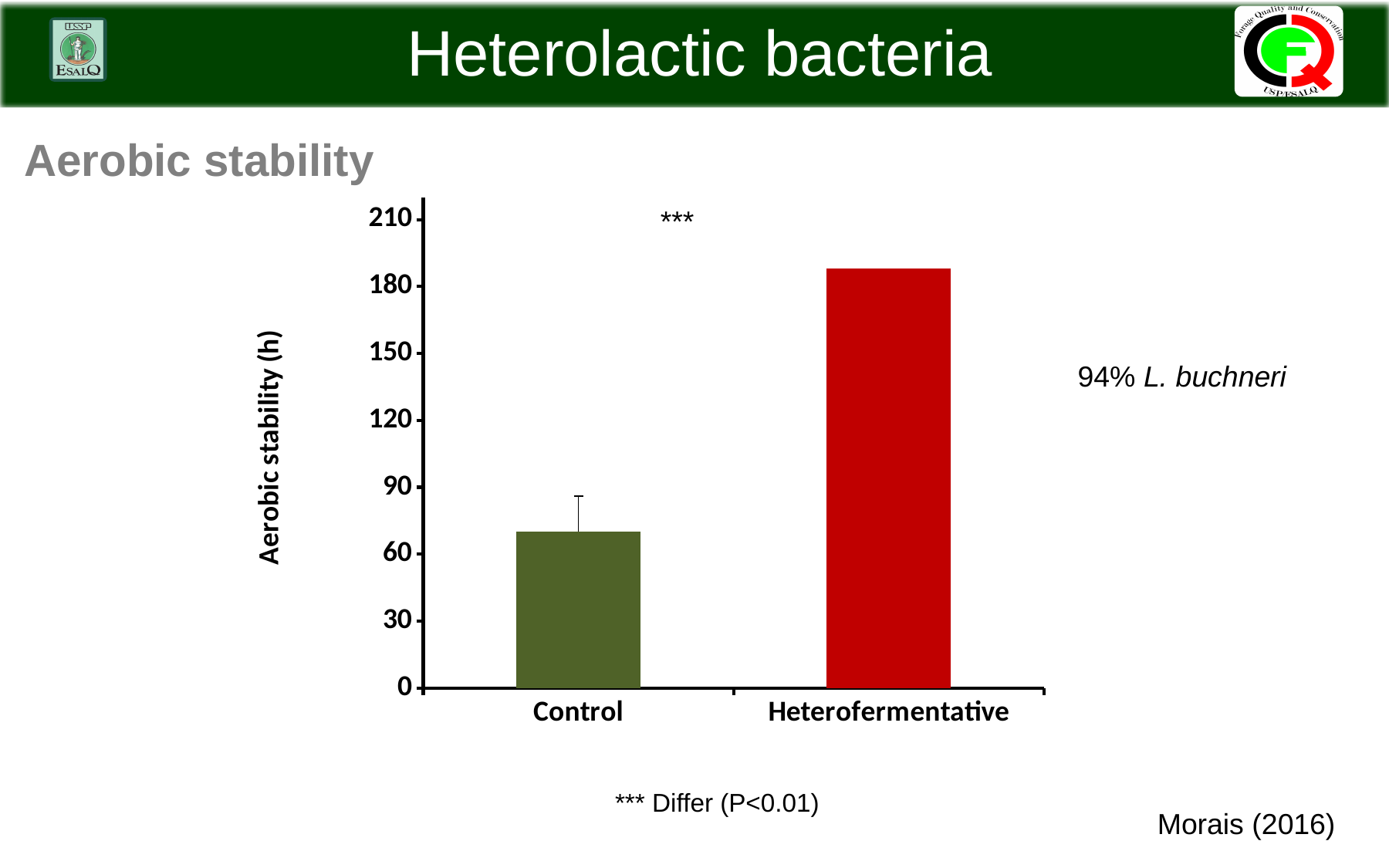
What is the label of the y axis? Aerobic stability (h) Is the value for Heterofermentative greater or less than 180? greater Which category has the highest aerobic stability? Heterofermentative Is the value for Heterofermentative greater or less than 210? less Which category has the lowest aerobic stability? Control Is the value for Control greater or less than 90? less What colour is the bar for Heterofermentative? red What kind of chart is shown on the slide? bar chart How many categories are plotted on the x axis? 2 Which is larger, the aerobic stability for Control or for Heterofermentative? Heterofermentative